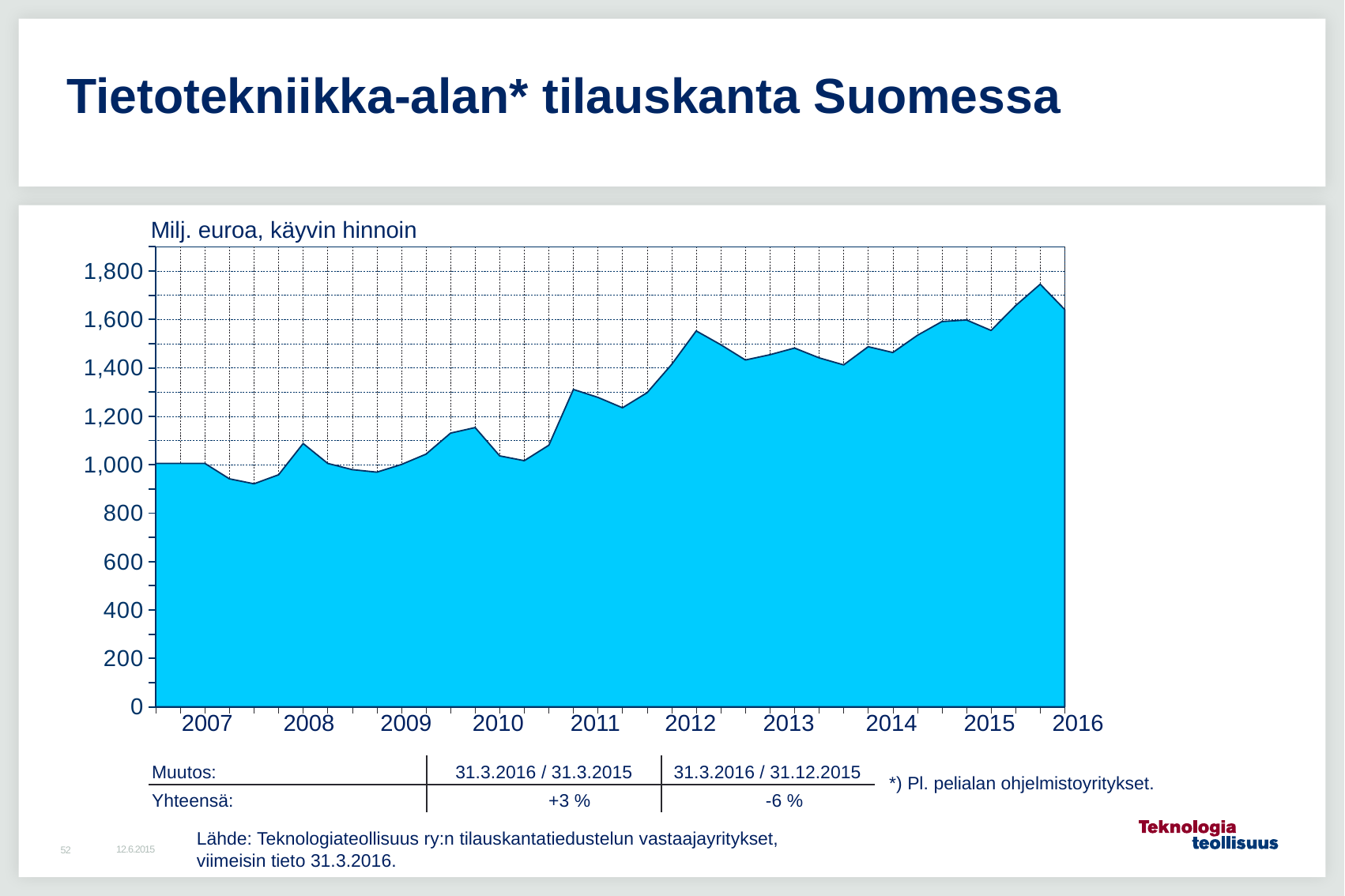
What kind of chart is shown on the slide? area chart How many year labels are shown on the x axis? 10 Is the value at the start of 2016 greater or less than 1,400? greater What is the title of the slide? Tietotekniikka-alan* tilauskanta Suomessa Which is larger, the value at the start of 2007 or the value at the start of 2016? 2016 Is the value at the start of 2009 greater or less than 1,200? less Is the value at the start of 2014 greater or less than 1,400? greater What unit is given for the values on the chart? Milj. euroa, käyvin hinnoin Which is larger, the value at the start of 2012 or the value at the start of 2010? 2012 Overall, do the values rise or fall from 2007 to 2016? rise